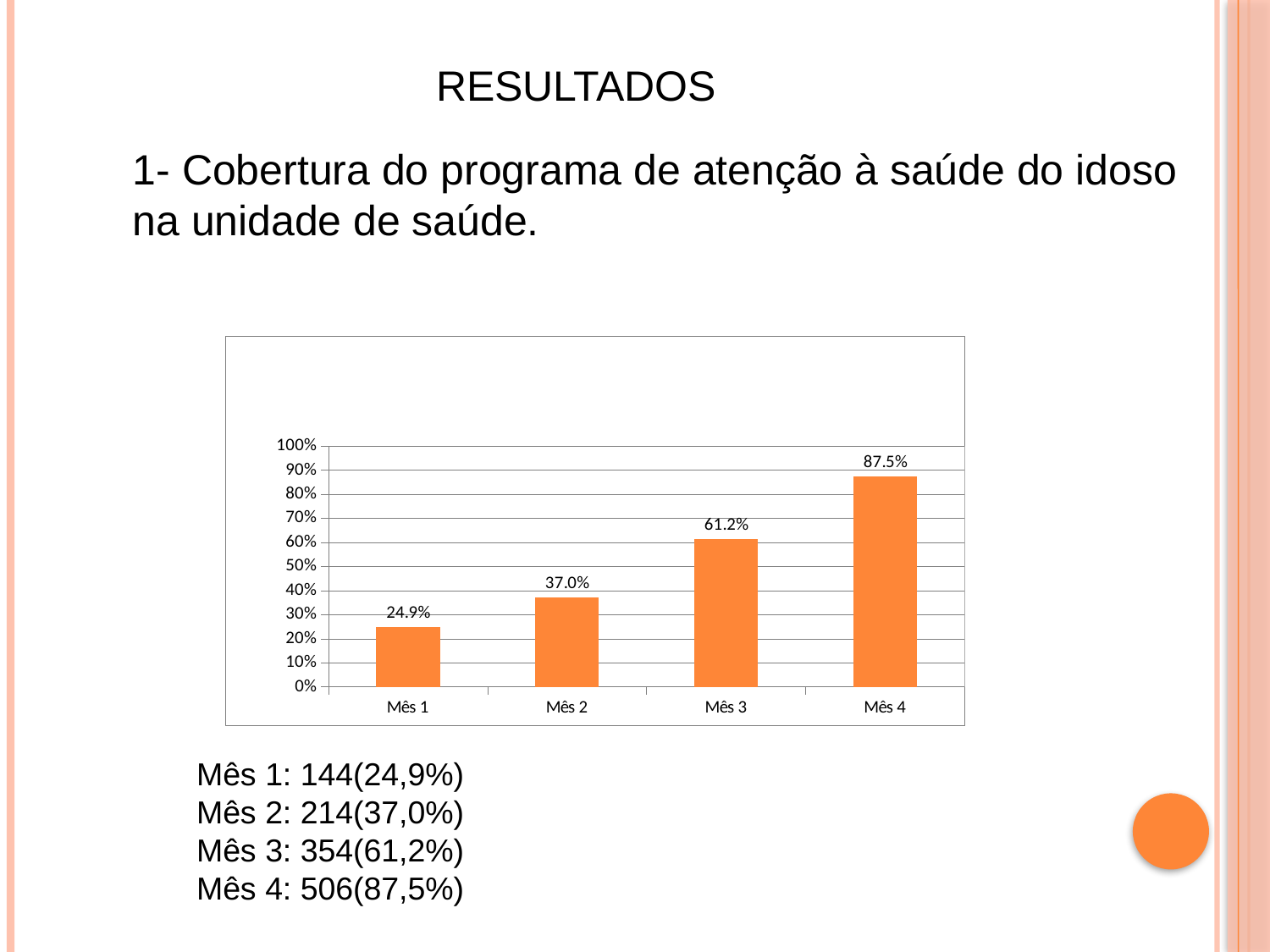
What is the value for Mês 4? 87.5% What is the value for Mês 1? 24.9% Which month has the highest value? Mês 4 How many months are shown on the x axis? 4 What is the difference between the values for Mês 3 and Mês 2? 24.2% Which is larger, the value for Mês 2 or the value for Mês 3? Mês 3 What is the difference between the values for Mês 4 and Mês 1? 62.6% What kind of chart is shown on the slide? Bar chart Do the values rise or fall from Mês 1 to Mês 4? Rise What is the value for Mês 3? 61.2% Which month has the lowest value? Mês 1 What is the value for Mês 2? 37.0%